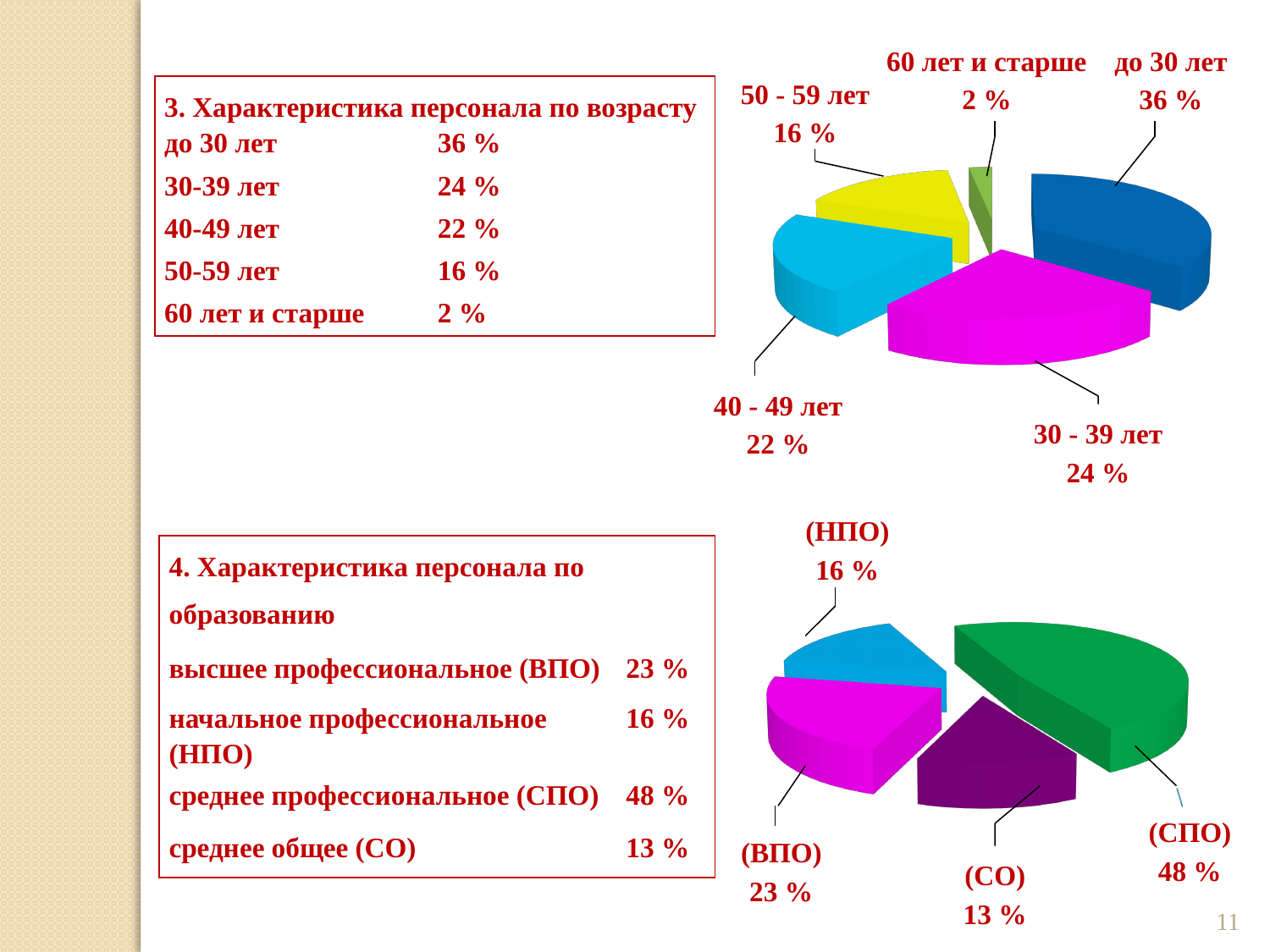
What type of chart is the bottom chart (personnel by education)? Pie chart In the bottom pie chart (personnel by education), what share is shown for the (СПО) slice? 48 % In the bottom pie chart (personnel by education), which is larger, the (ВПО) slice or the (НПО) slice? (ВПО) In the top pie chart (personnel by age), which age group has the smallest share? 60 лет и старше In the top pie chart (personnel by age), what share is shown for the '40 - 49 лет' slice? 22 % In the top pie chart (personnel by age), what share is shown for the 'до 30 лет' slice? 36 % In the top pie chart (personnel by age), what is the difference in percentage points between the '30 - 39 лет' and '50 - 59 лет' slices? 8 In the bottom pie chart (personnel by education), which category has the smallest share? (СО) In the bottom pie chart (personnel by education), what colour is the (СПО) slice? Green In the top pie chart (personnel by age), how many slices are there? 5 In the bottom pie chart (personnel by education), how many slices are there? 4 In the top pie chart (personnel by age), which age group has the largest share? до 30 лет